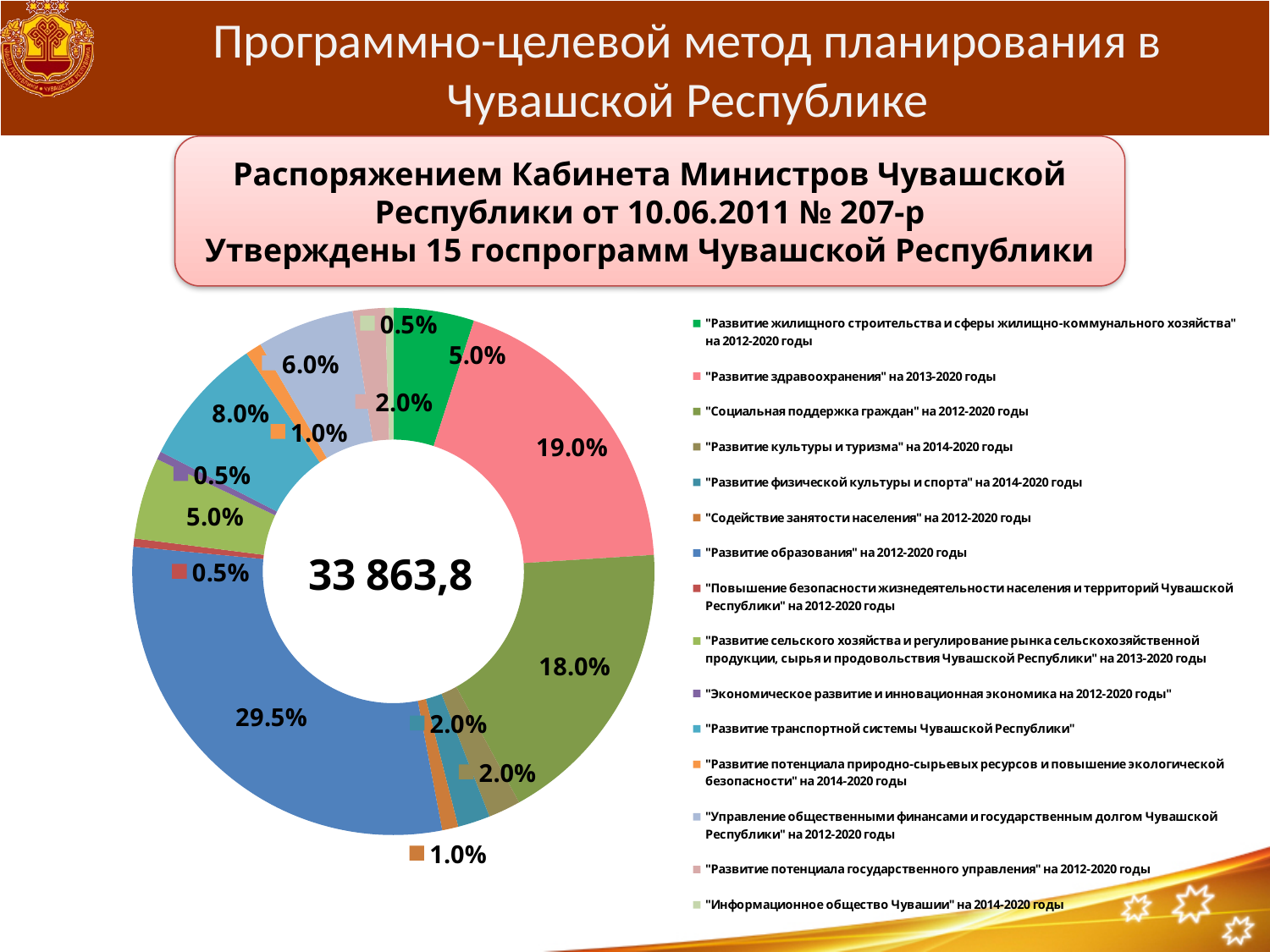
What share is shown for the program "Управление общественными финансами и государственным долгом Чувашской Республики" на 2012-2020 годы? 6.0% What kind of chart is shown on the slide? Doughnut (pie) chart What share is shown for the program "Развитие здравоохранения" на 2013-2020 годы? 19.0% What share is shown for the program "Социальная поддержка граждан" на 2012-2020 годы? 18.0% What number is printed in the centre of the doughnut chart? 33 863,8 Which program has the largest share of the doughnut chart? "Развитие образования" на 2012-2020 годы What is the difference in percentage points between the share for "Развитие образования" (29.5%) and the share for "Развитие здравоохранения" (19.0%)? 10.5 Which has a larger share: "Развитие здравоохранения" or "Социальная поддержка граждан"? "Развитие здравоохранения" What share is shown for the program "Развитие образования" на 2012-2020 годы? 29.5% What share is shown for the program "Развитие транспортной системы Чувашской Республики"? 8.0% How many slices does the doughnut chart have? 15 How many entries does the chart legend list? 15